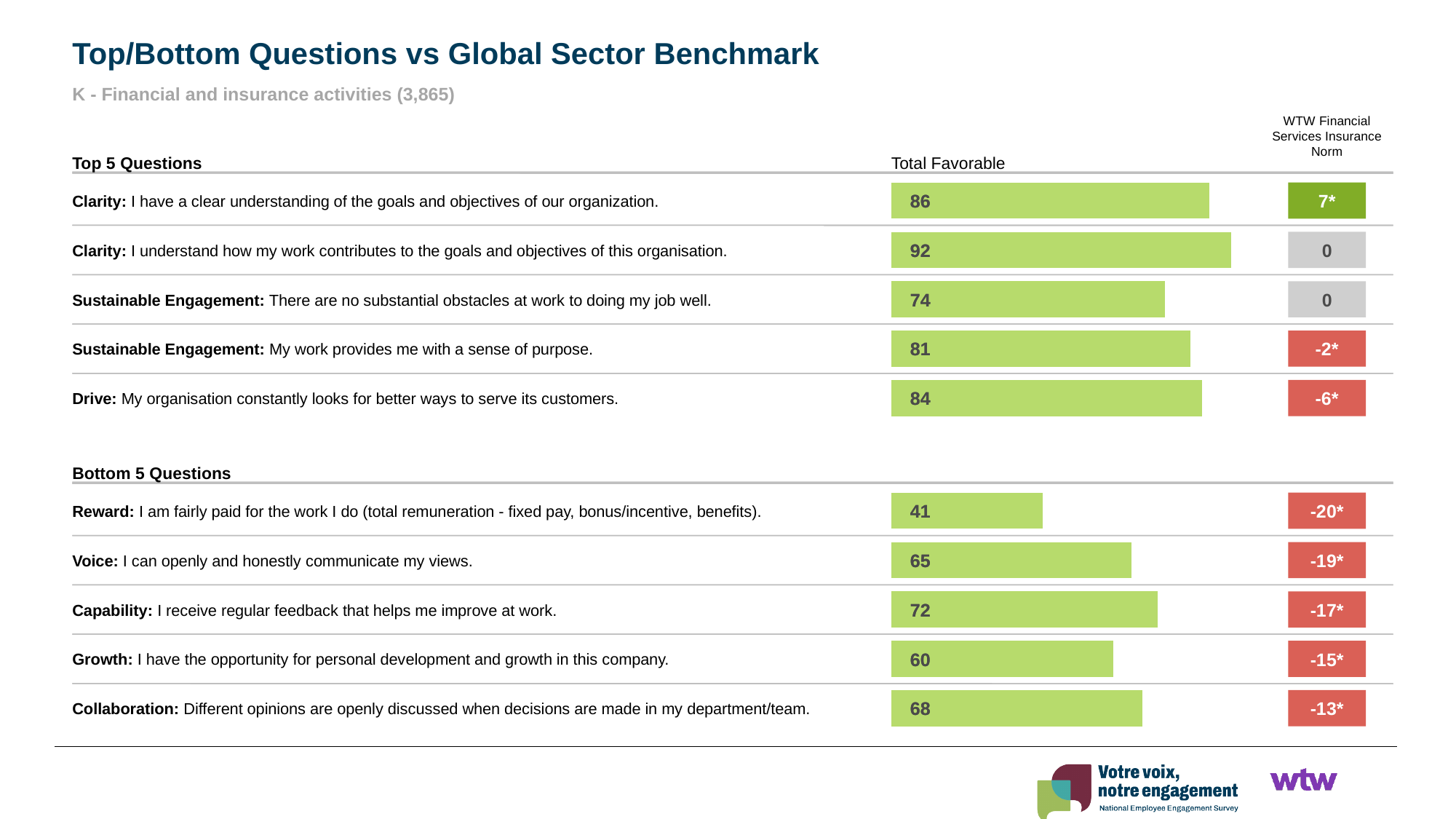
In the Bottom 5 Questions chart, which has a higher Total Favorable value: the Capability question or the Collaboration question? Capability In the Top 5 Questions chart, what is the difference in Total Favorable between the two Clarity questions (92 and 86)? 6 In the Bottom 5 Questions chart, what is the WTW Financial Services Insurance Norm difference shown for the Voice question? -19* In the Top 5 Questions chart, what is the WTW Financial Services Insurance Norm difference shown for "Drive: My organisation constantly looks for better ways to serve its customers"? -6* In the Bottom 5 Questions chart, what is the Total Favorable value for "Reward: I am fairly paid for the work I do"? 41 In the Bottom 5 Questions chart, which question has the lowest Total Favorable value? Reward: I am fairly paid for the work I do (total remuneration - fixed pay, bonus/incentive, benefits). What kind of chart is used to show the Total Favorable values? Bar chart In the Top 5 Questions chart, which question has the highest Total Favorable value? Clarity: I understand how my work contributes to the goals and objectives of this organisation. What is the title of the slide containing the charts? Top/Bottom Questions vs Global Sector Benchmark In the Top 5 Questions chart, what is the Total Favorable value for "Sustainable Engagement: There are no substantial obstacles at work to doing my job well"? 74 How many questions are plotted in the Bottom 5 Questions chart? 5 In the Top 5 Questions chart, what is the Total Favorable value for "Clarity: I understand how my work contributes to the goals and objectives of this organisation"? 92